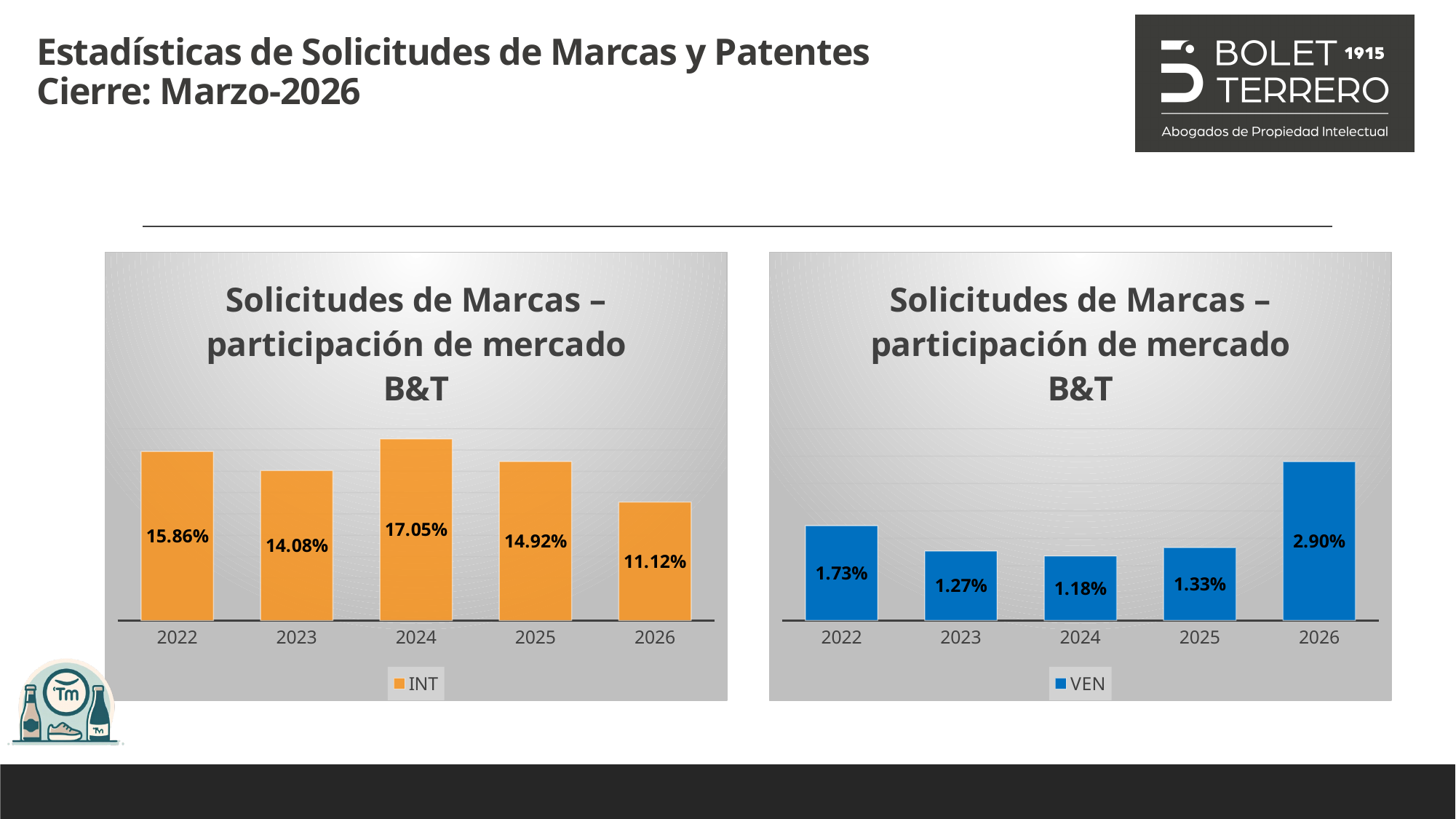
In the left chart (INT), which is larger, the value for 2022 or the value for 2025? 2022 What type of chart is the right chart (VEN)? Bar chart In the left chart (INT), which year has the lowest value? 2026 In the right chart (VEN), which year has the lowest value? 2024 What series name does the legend of the left chart show? INT In the left chart (INT), what is the difference between the 2024 value and the 2026 value? 5.93% In the right chart (VEN), what is the value for 2026? 2.90% In the right chart (VEN), which is larger, the value for 2023 or the value for 2025? 2025 In the right chart (VEN), which year has the highest value? 2026 How many years are shown on the x axis of the left chart (INT)? 5 In the right chart (VEN), what is the difference between the 2026 value and the 2024 value? 1.72% In the left chart (INT), what is the value for 2024? 17.05%